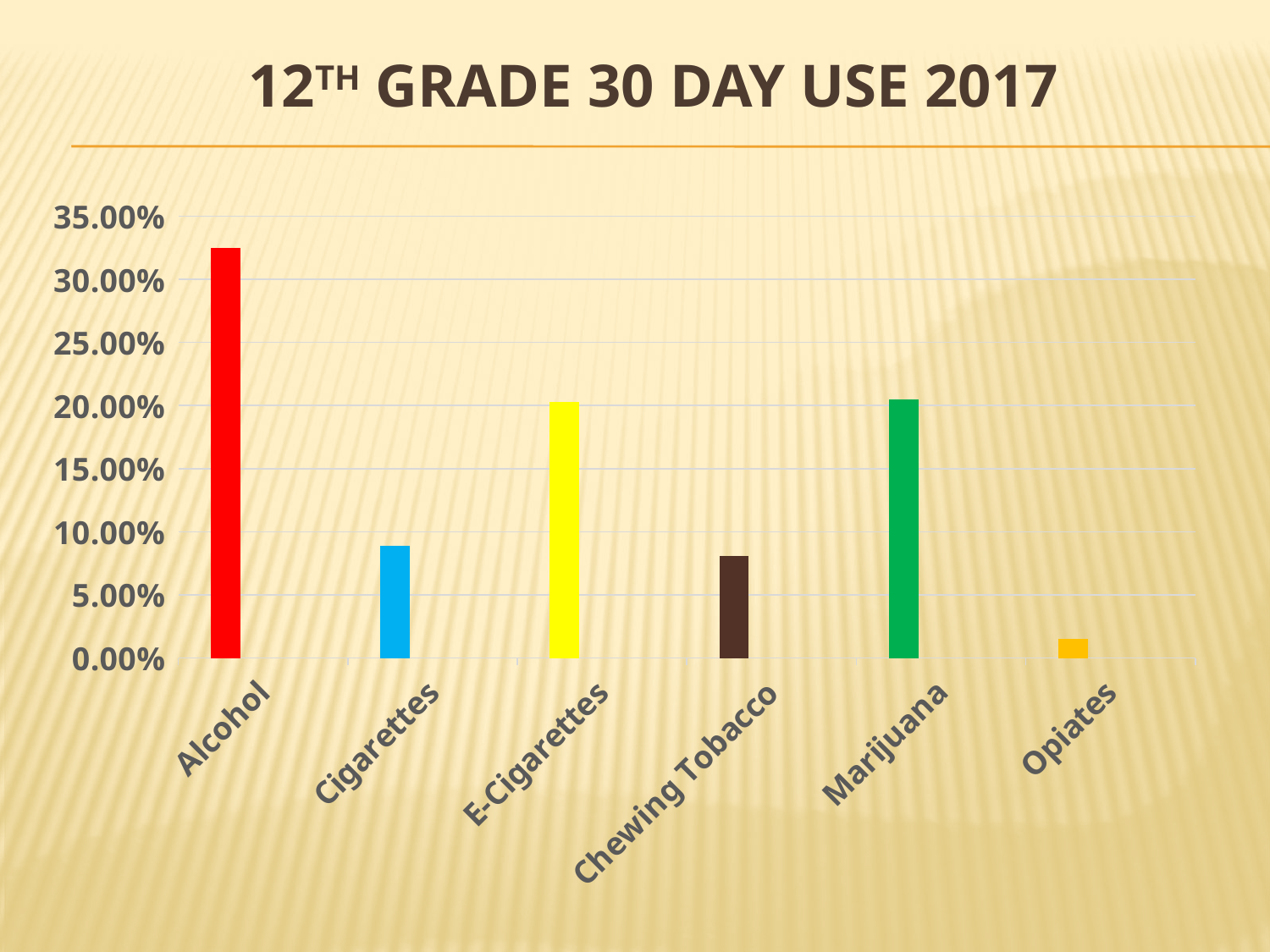
Which category has the highest 30 day use value? Alcohol Is the value for Opiates greater or less than 5.00%? less What is the title of the chart? 12th Grade 30 Day Use 2017 What type of chart is shown on the slide? bar chart Is the value for Alcohol greater or less than 30.00%? greater Which is larger, the value for Alcohol or the value for Marijuana? Alcohol Which category has the lowest 30 day use value? Opiates Which is larger, the value for E-Cigarettes or the value for Chewing Tobacco? E-Cigarettes Is the value for Chewing Tobacco greater or less than 10.00%? less How many categories are shown on the x axis of the chart? 6